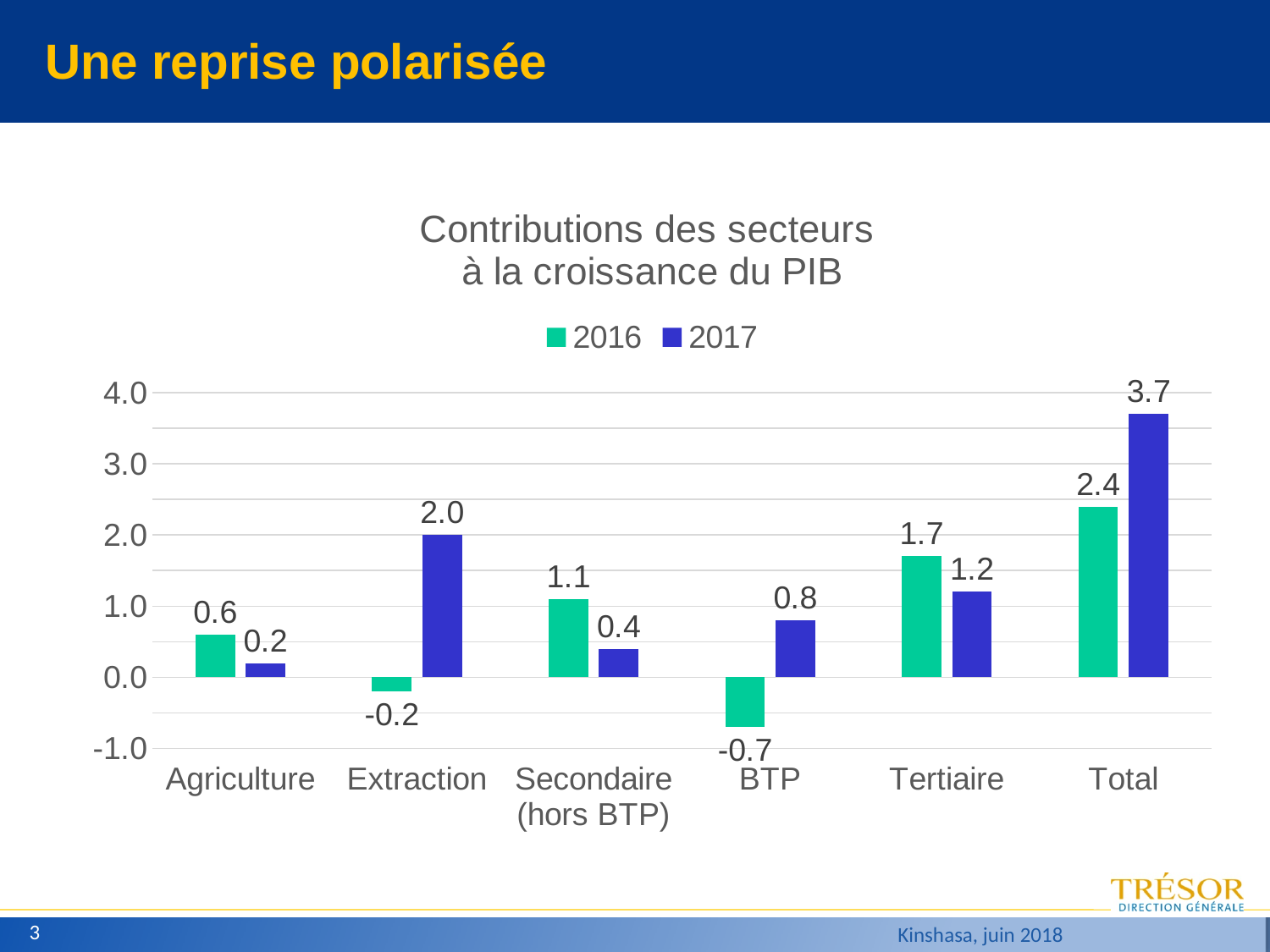
Which category has the lowest 2016 value? BTP What is the 2016 value for BTP? -0.7 What is the difference between the 2017 and 2016 values for Total? 1.3 What kind of chart is shown on the slide? Bar chart What is the difference between the 2017 and 2016 values for Extraction? 2.2 How many categories are shown on the x axis? 6 Which category has the highest 2017 value? Total How many series does the legend list? 2 What is the 2017 value for Extraction? 2.0 What is the title of the chart? Contributions des secteurs à la croissance du PIB What is the 2017 value for Secondaire (hors BTP)? 0.4 For Tertiaire, which series has the larger value, 2016 or 2017? 2016